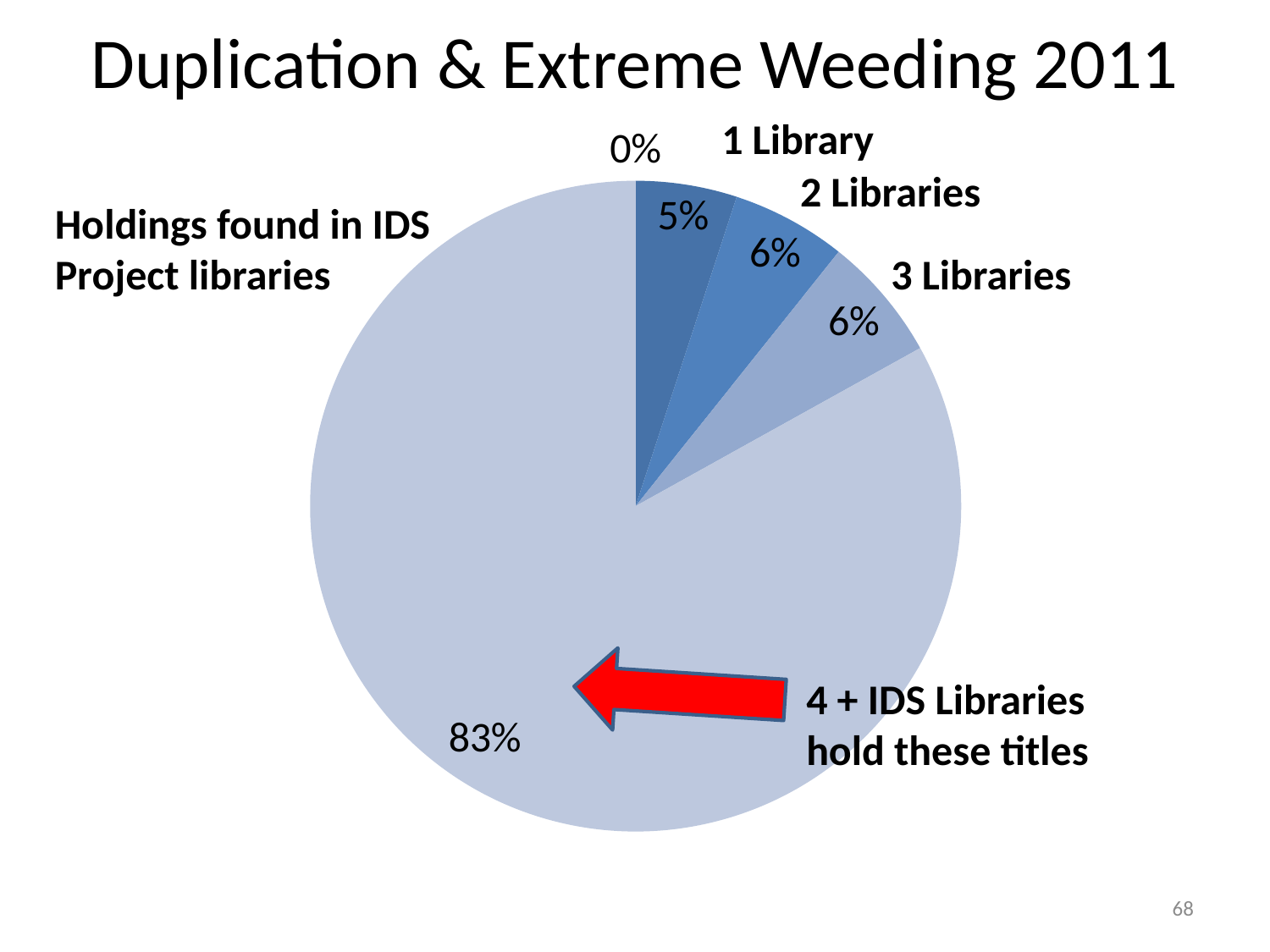
What share of the pie is held by 4 + IDS Libraries? 83% What type of chart is shown on the slide? pie chart How many percentage labels are printed on the pie chart? 5 What percentage of holdings are found in 3 Libraries? 6% Is the share for 4 + IDS Libraries larger or smaller than the share for 1 Library? larger What percentage of holdings are found in only 1 Library? 5% What percentage of holdings are found in 2 Libraries? 6% Which of the named library categories has the smallest slice of the pie? 1 Library What is the title of the slide containing the pie chart? Duplication & Extreme Weeding 2011 Which category has the largest slice of the pie? 4 + IDS Libraries What is the difference in percentage points between the 4 + IDS Libraries slice and the 1 Library slice? 78 What is the combined percentage for the 1 Library, 2 Libraries and 3 Libraries slices? 17%